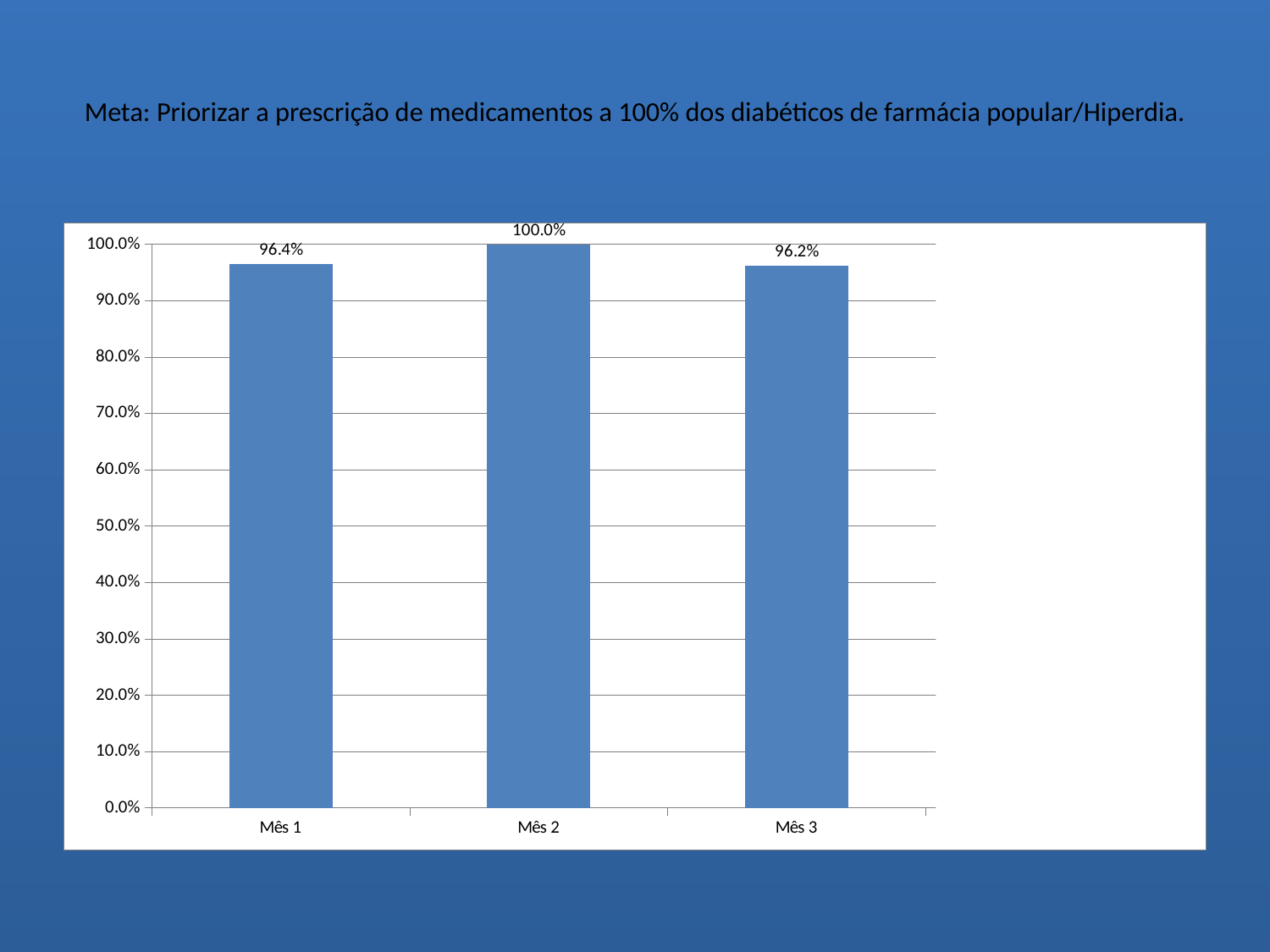
Is the value for Mês 3 greater or less than 90.0%? greater What is the difference between the values for Mês 2 and Mês 3? 3.8% Which is larger, the value for Mês 2 or the value for Mês 3? Mês 2 How many months are shown on the x axis? 3 What is the value for Mês 3? 96.2% What kind of chart is shown on the slide? bar chart Which month has the highest value? Mês 2 What colour are the bars in the chart? blue What is the value for Mês 1? 96.4% What is the value for Mês 2? 100.0% Does the value rise or fall from Mês 2 to Mês 3? fall What is the difference between the values for Mês 2 and Mês 1? 3.6%